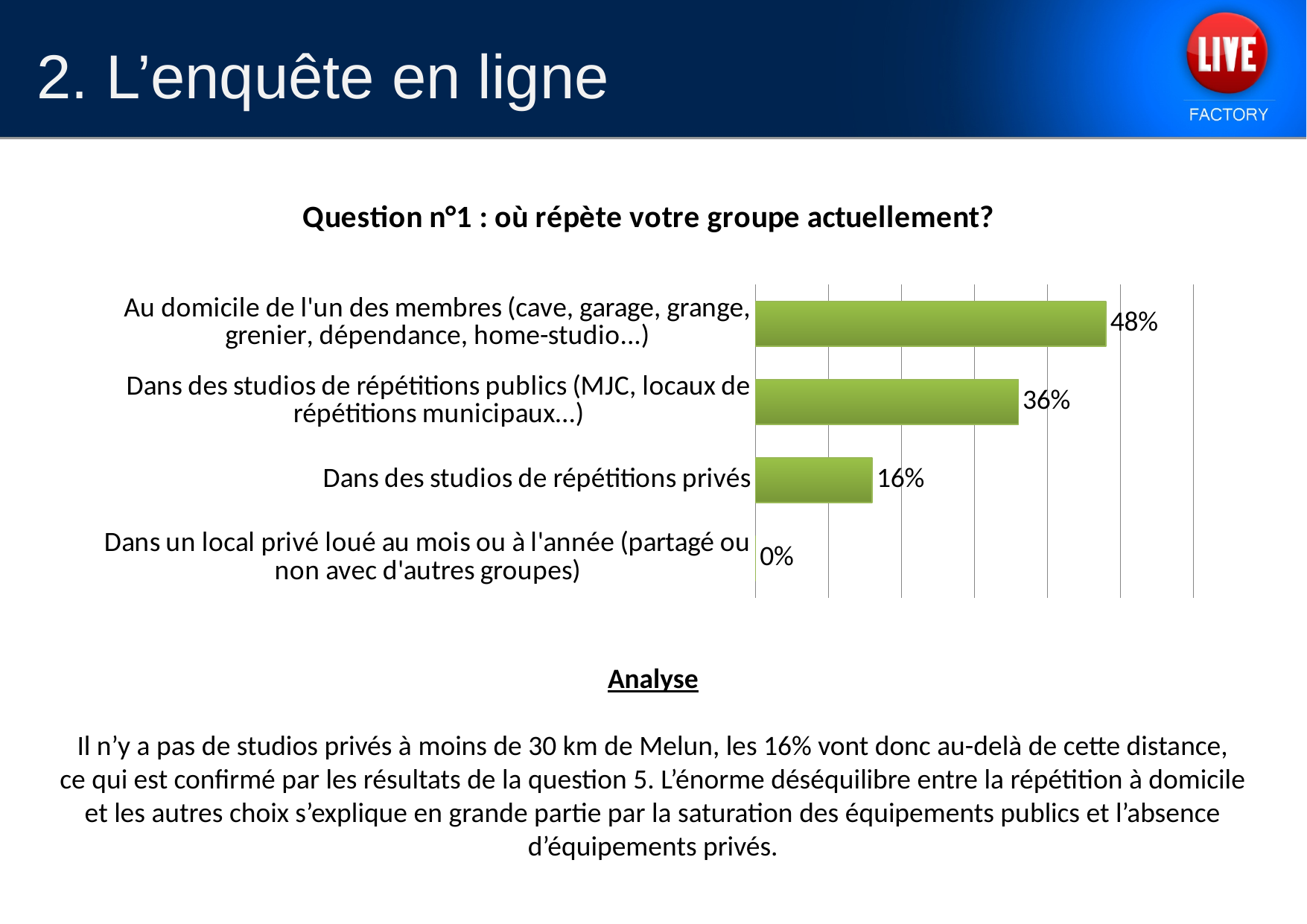
What is the value for 'Dans des studios de répétitions privés'? 16% What is the difference between the value for public rehearsal studios and the value for private rehearsal studios? 20% What kind of chart is shown on the slide? Bar chart Which is larger: the value for 'Dans des studios de répétitions publics' or the value for 'Dans des studios de répétitions privés'? Dans des studios de répétitions publics What is the title of the chart? Question n°1 : où répète votre groupe actuellement? What percentage of groups rehearse at the home of one of the members (Au domicile de l'un des membres)? 48% What is the value for 'Dans des studios de répétitions publics (MJC, locaux de répétitions municipaux...)'? 36% Which category has the highest value? Au domicile de l'un des membres (cave, garage, grange, grenier, dépendance, home-studio...) Which category has the lowest value? Dans un local privé loué au mois ou à l'année (partagé ou non avec d'autres groupes) What is the difference between the value for rehearsing at a member's home and the value for public rehearsal studios? 12% How many categories are shown in the chart? 4 What is the value for 'Dans un local privé loué au mois ou à l'année'? 0%